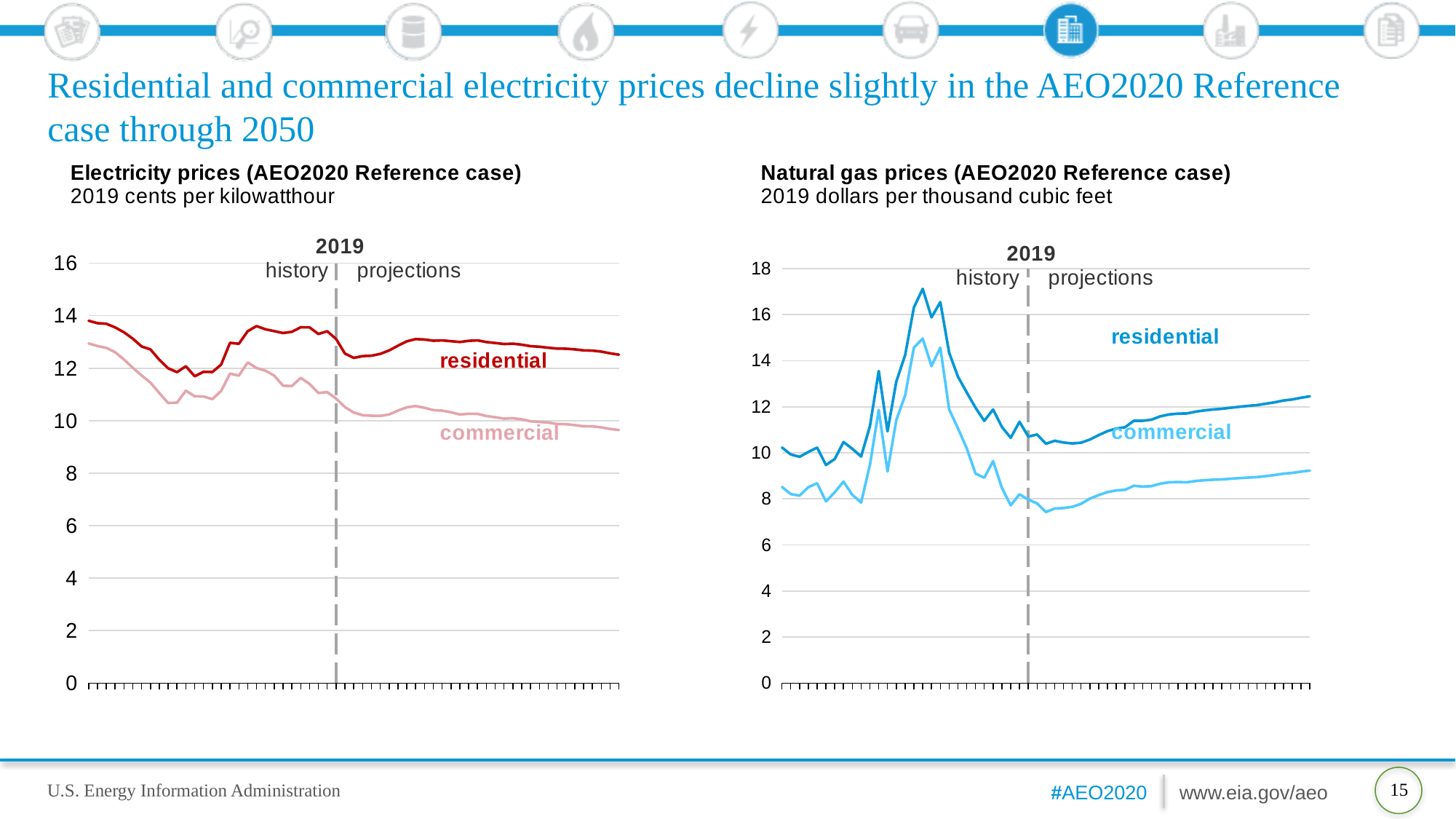
What year separates history from projections on the 'Electricity prices (AEO2020 Reference case)' chart? 2019 On the 'Electricity prices (AEO2020 Reference case)' chart, do the residential prices rise or fall over the projection period after their early peak? fall On the 'Electricity prices (AEO2020 Reference case)' chart, is the residential value at the end of the projection period greater or less than 12? greater On the 'Natural gas prices (AEO2020 Reference case)' chart, is the peak residential value greater or less than 16? greater How many series are plotted on the 'Natural gas prices (AEO2020 Reference case)' chart? 2 What unit is used on the 'Natural gas prices (AEO2020 Reference case)' chart? 2019 dollars per thousand cubic feet What kind of chart is the 'Electricity prices (AEO2020 Reference case)' chart? line chart On the 'Natural gas prices (AEO2020 Reference case)' chart, which series reaches a higher peak, residential or commercial? residential On the 'Electricity prices (AEO2020 Reference case)' chart, is the commercial value at the end of the projection period greater or less than 12? less On the 'Natural gas prices (AEO2020 Reference case)' chart, do the residential prices rise or fall over the projection period? rise On the 'Electricity prices (AEO2020 Reference case)' chart, which series is higher throughout, residential or commercial? residential